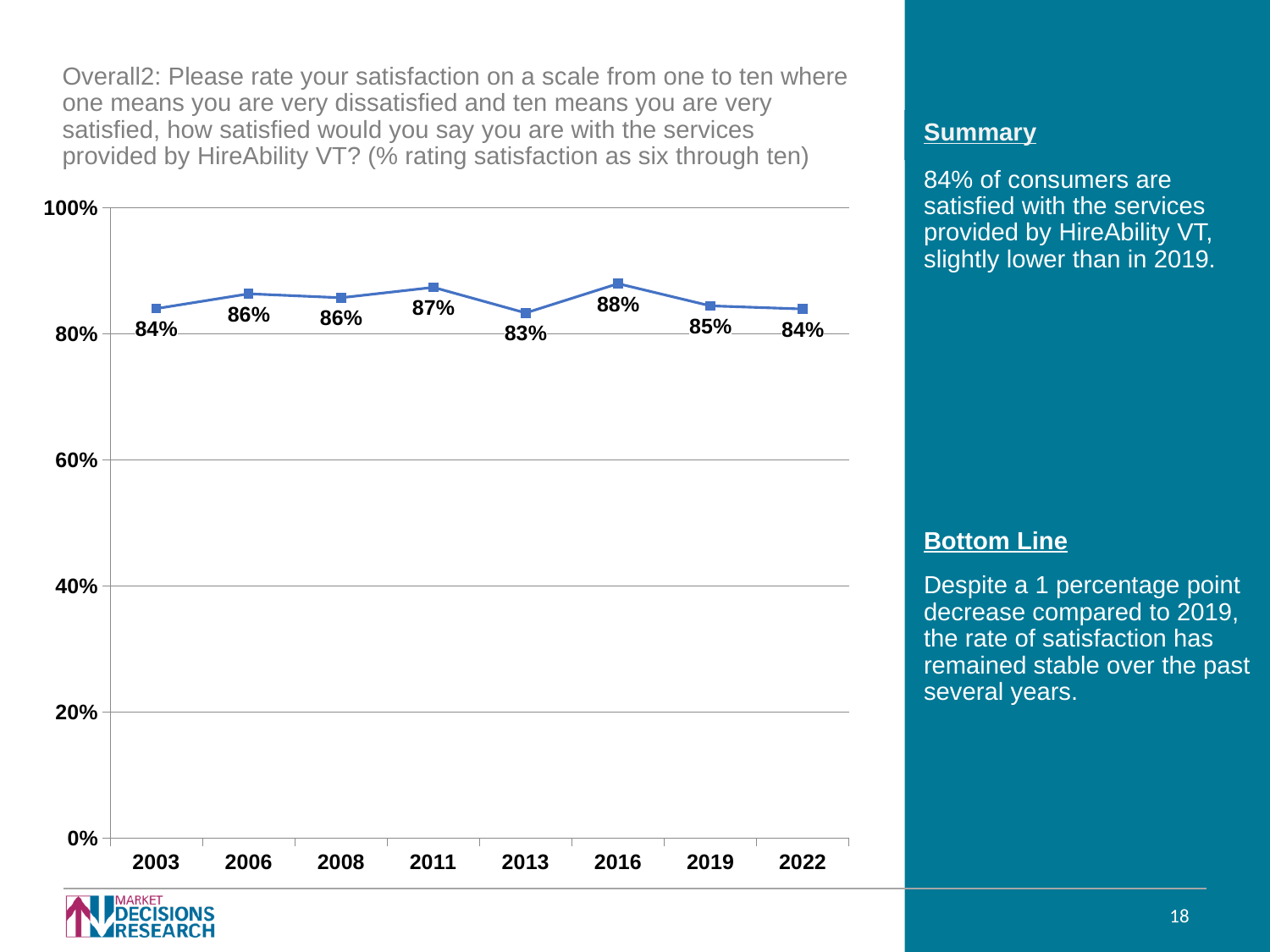
Which year has the highest satisfaction percentage? 2016 What is the satisfaction value shown for 2022? 84% What is the difference in percentage points between the 2019 and 2022 values? 1 What kind of chart is shown on the slide? line chart Which year has the lowest satisfaction percentage? 2013 What is the difference in percentage points between the 2016 and 2013 values? 5 How many years are plotted on the chart? 8 What percentage of consumers rated their satisfaction as six through ten in 2016? 88% What is the satisfaction value shown for 2013? 83% Does the satisfaction value rise or fall from 2019 to 2022? fall Which year has a higher satisfaction value, 2011 or 2019? 2011 Is the value for 2013 greater or less than 80%? greater